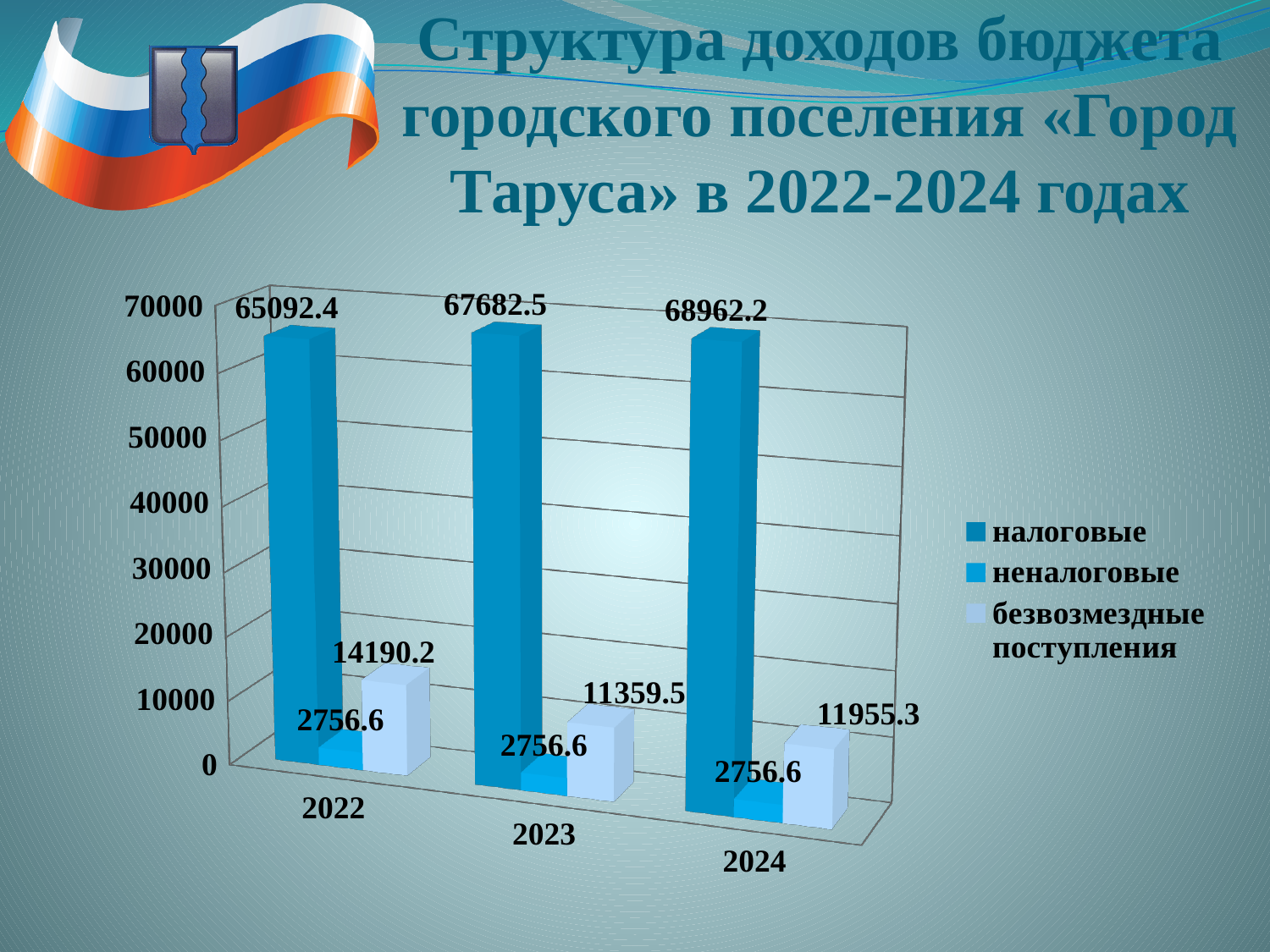
In which year is the value of безвозмездные поступления the lowest? 2023 What is the value of неналоговые for 2024? 2756.6 What type of chart is shown on the slide? bar chart Do the налоговые values rise or fall from 2022 to 2024? rise What is the difference between the налоговые values for 2024 and 2022? 3869.8 What is the value of налоговые for 2022? 65092.4 Which series is shown in the lightest colour in the legend? безвозмездные поступления What is the value of безвозмездные поступления for 2023? 11359.5 How many series does the legend list? 3 Which is larger: безвозмездные поступления in 2022 or in 2024? 2022 How many years are shown on the x axis? 3 In which year is the value of налоговые the highest? 2024